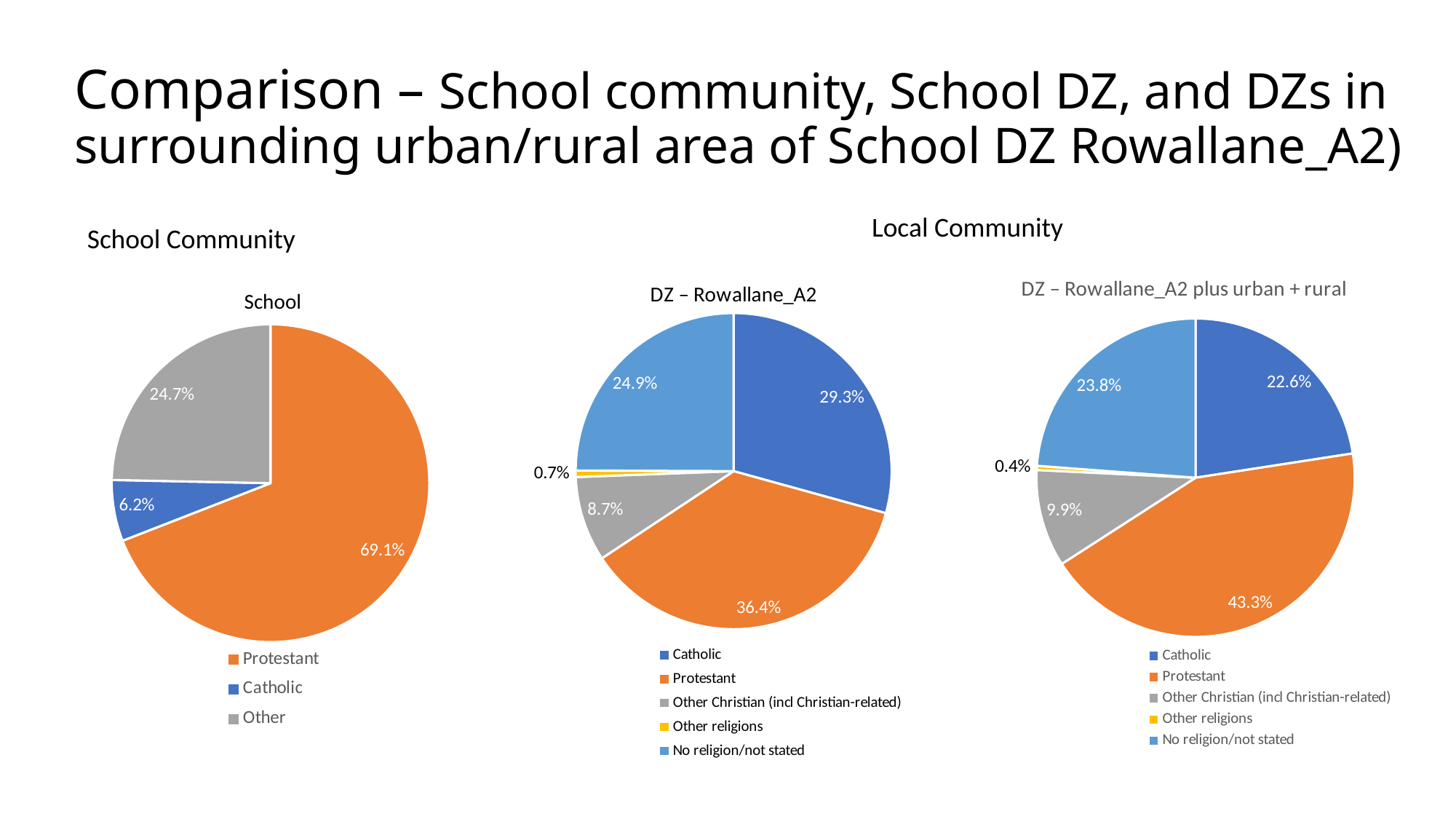
How many categories does the legend of the 'DZ – Rowallane_A2' chart list? 5 In the 'DZ – Rowallane_A2' pie chart, which category has the smallest share? Other religions In the 'DZ – Rowallane_A2' pie chart, what percentage is Other religions? 0.7% What kind of chart is the 'School' chart? Pie chart In the 'School' pie chart, what percentage is Catholic? 6.2% In the 'DZ – Rowallane_A2 plus urban + rural' pie chart, what percentage is No religion/not stated? 23.8% In the 'School' pie chart, what percentage is Protestant? 69.1% In the 'DZ – Rowallane_A2 plus urban + rural' pie chart, which is larger: Catholic or Other Christian (incl Christian-related)? Catholic In the 'DZ – Rowallane_A2' pie chart, what is the difference between the Protestant and Catholic shares? 7.1% In the 'School' pie chart, which category has the largest share? Protestant In the 'DZ – Rowallane_A2 plus urban + rural' pie chart, what percentage is Protestant? 43.3% In the 'DZ – Rowallane_A2' pie chart, what percentage is Catholic? 29.3%